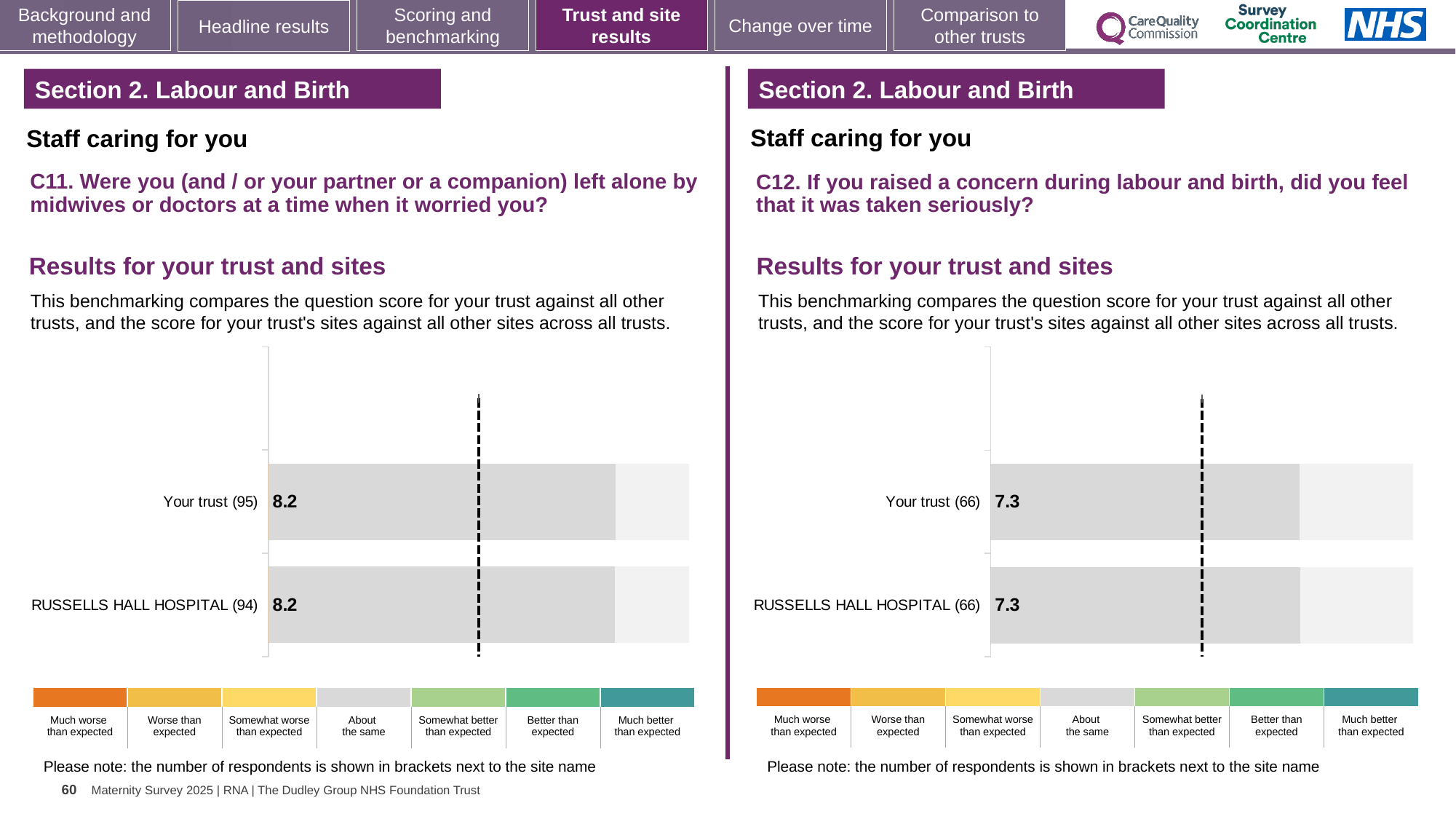
How many bars are plotted in the left chart (C11)? 2 In the left chart (C11), what is the score for Your trust? 8.2 In the left chart (C11), what is the score for RUSSELLS HALL HOSPITAL? 8.2 How many bars are plotted in the right chart (C12)? 2 What kind of chart is used in the left chart (C11)? Bar chart In the right chart (C12), what is the score for Your trust? 7.3 In the left chart (C11), how many respondents are shown in brackets for Your trust? 95 In the right chart (C12), what is the score for RUSSELLS HALL HOSPITAL? 7.3 In the left chart (C11), what is the difference between the score for Your trust and the score for RUSSELLS HALL HOSPITAL? 0.0 In the right chart (C12), how many respondents are shown in brackets for RUSSELLS HALL HOSPITAL? 66 In the right chart (C12), what is the difference between the score for Your trust and the score for RUSSELLS HALL HOSPITAL? 0.0 Is the score for Your trust in the left chart (C11) larger or smaller than the score for Your trust in the right chart (C12)? Larger